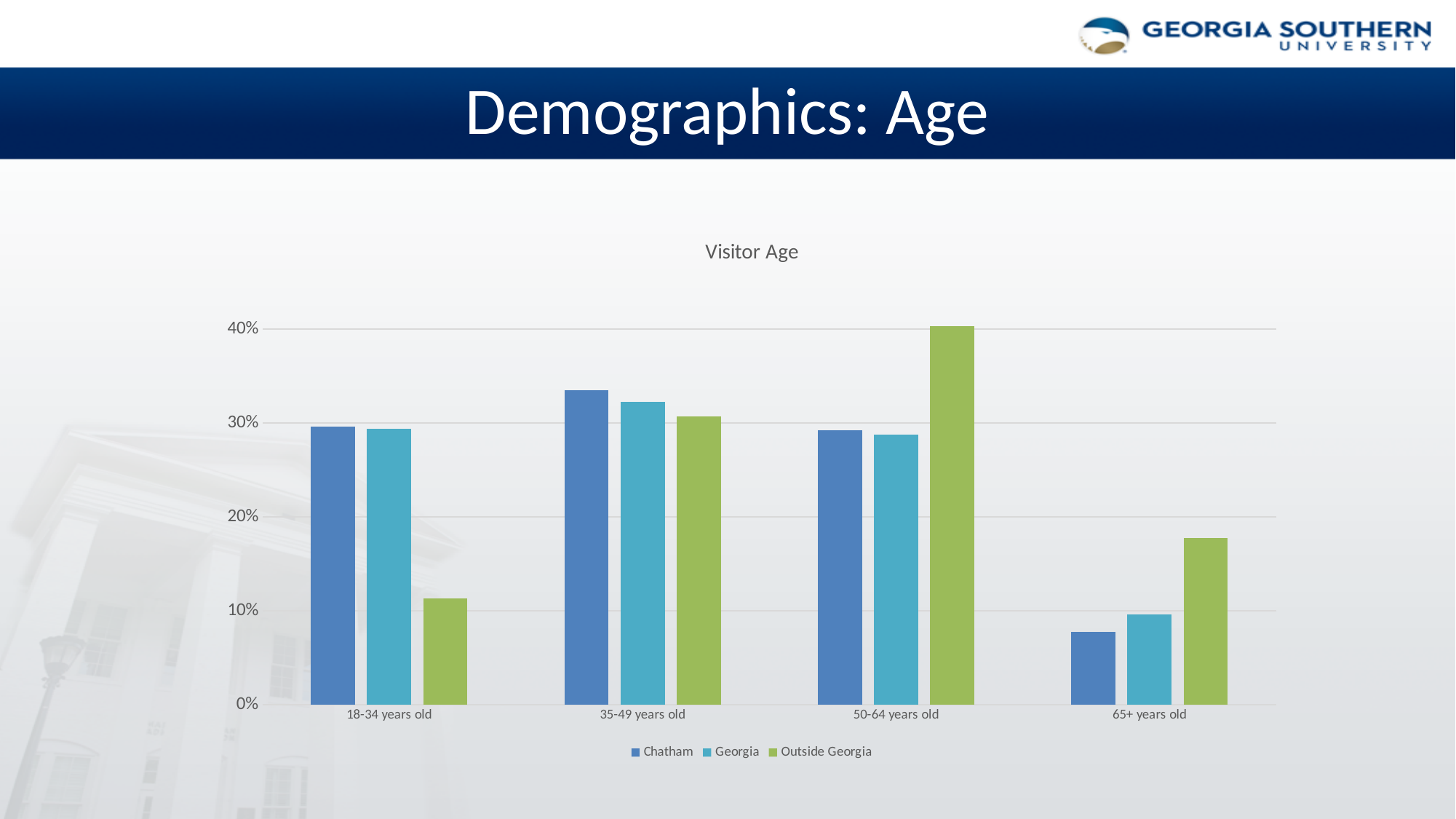
For which age group is the Outside Georgia value lowest? 18-34 years old What kind of chart is shown on the slide? bar chart Is the Outside Georgia value for 18-34 years old greater or less than 20%? less In the 50-64 years old group, which is larger: Chatham or Outside Georgia? Outside Georgia For which age group is the Chatham value lowest? 65+ years old Is the Georgia value for 35-49 years old greater or less than 30%? greater How many series does the legend list? 3 What is the title of the chart? Visitor Age For which age group is the Outside Georgia value highest? 50-64 years old How many age categories are shown on the x axis? 4 Is the Chatham value for 65+ years old greater or less than 10%? less For which age group is the Chatham value highest? 35-49 years old